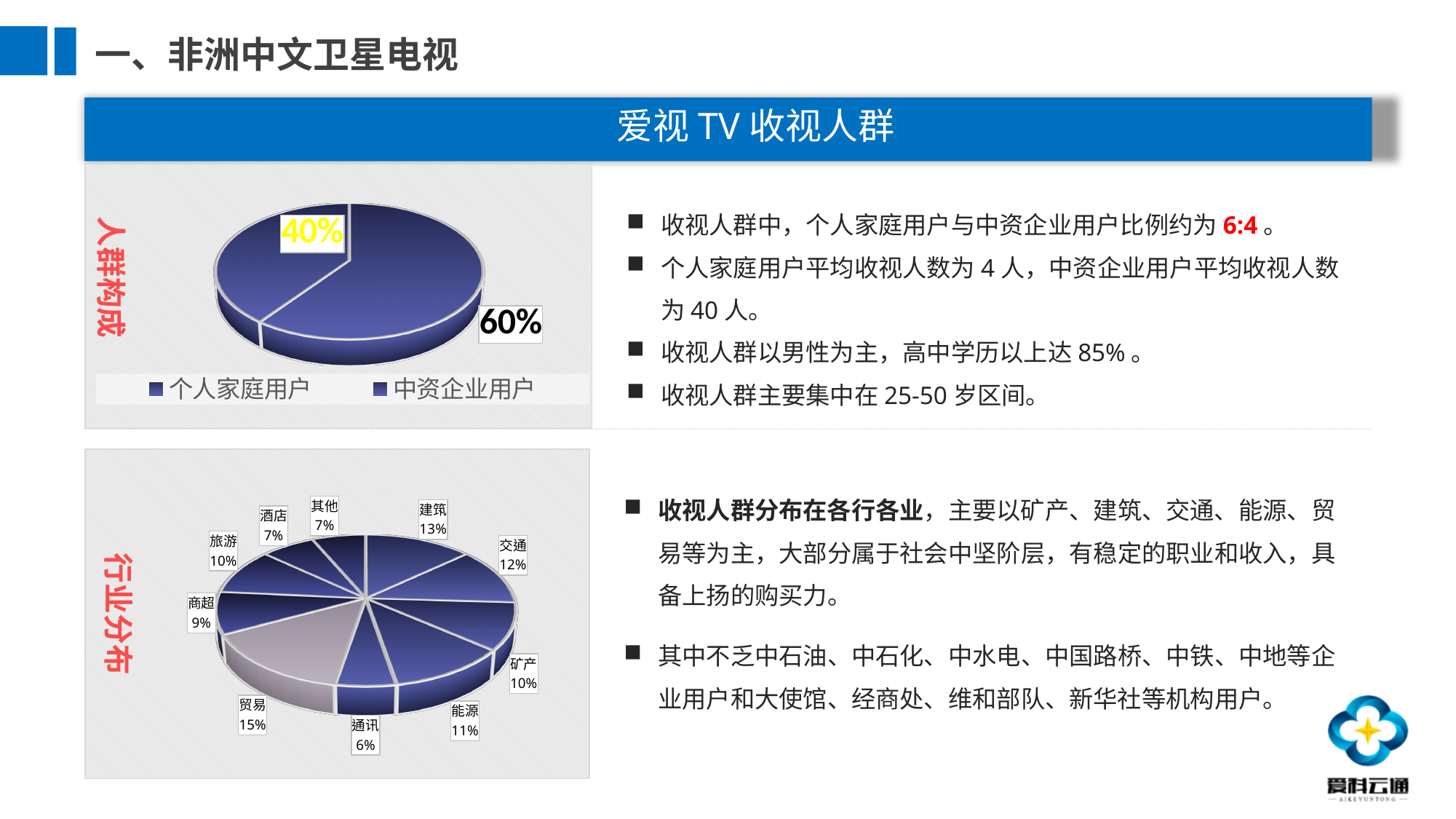
In the bottom pie chart (行业分布), which industry has the largest share? 贸易 How many entries does the legend of the top pie chart (人群构成) list? 2 In the bottom pie chart (行业分布), what is the share for 通讯? 6% In the bottom pie chart (行业分布), how many industry categories are shown? 10 What kind of chart is the top chart (人群构成)? Pie chart In the top pie chart (人群构成), what share is shown for 个人家庭用户? 60% In the bottom pie chart (行业分布), what is the share for 贸易? 15% In the bottom pie chart (行业分布), which industry has the smallest share? 通讯 In the bottom pie chart (行业分布), what is the difference between the shares of 交通 and 矿产? 2% In the top pie chart (人群构成), what share is shown for 中资企业用户? 40% In the bottom pie chart (行业分布), what is the share for 建筑? 13% In the bottom pie chart (行业分布), which has a larger share, 能源 or 商超? 能源